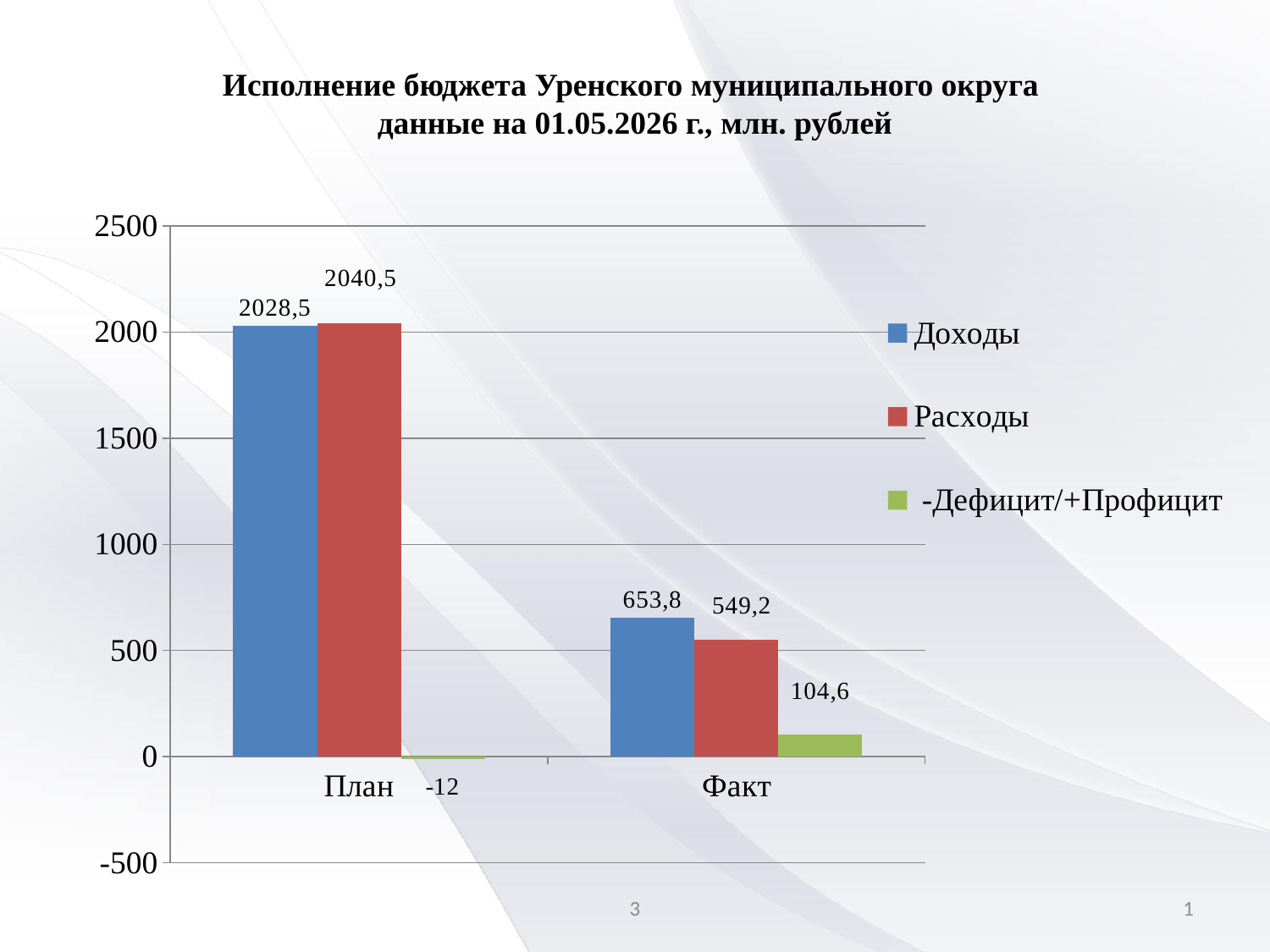
What is the value of -Дефицит/+Профицит for Факт? 104,6 How many categories are shown on the x axis? 2 Which category has the higher value for Расходы, План or Факт? План What is the difference between Расходы and Доходы for План? 12 Which series is shown in green in the legend? -Дефицит/+Профицит What is the value of Доходы for План? 2028,5 Is the value of Доходы for Факт greater or less than 500? greater What is the value of -Дефицит/+Профицит for План? -12 How many series does the legend list? 3 What kind of chart is shown on the slide? bar chart What is the difference between Доходы and Расходы for Факт? 104,6 What is the value of Расходы for Факт? 549,2